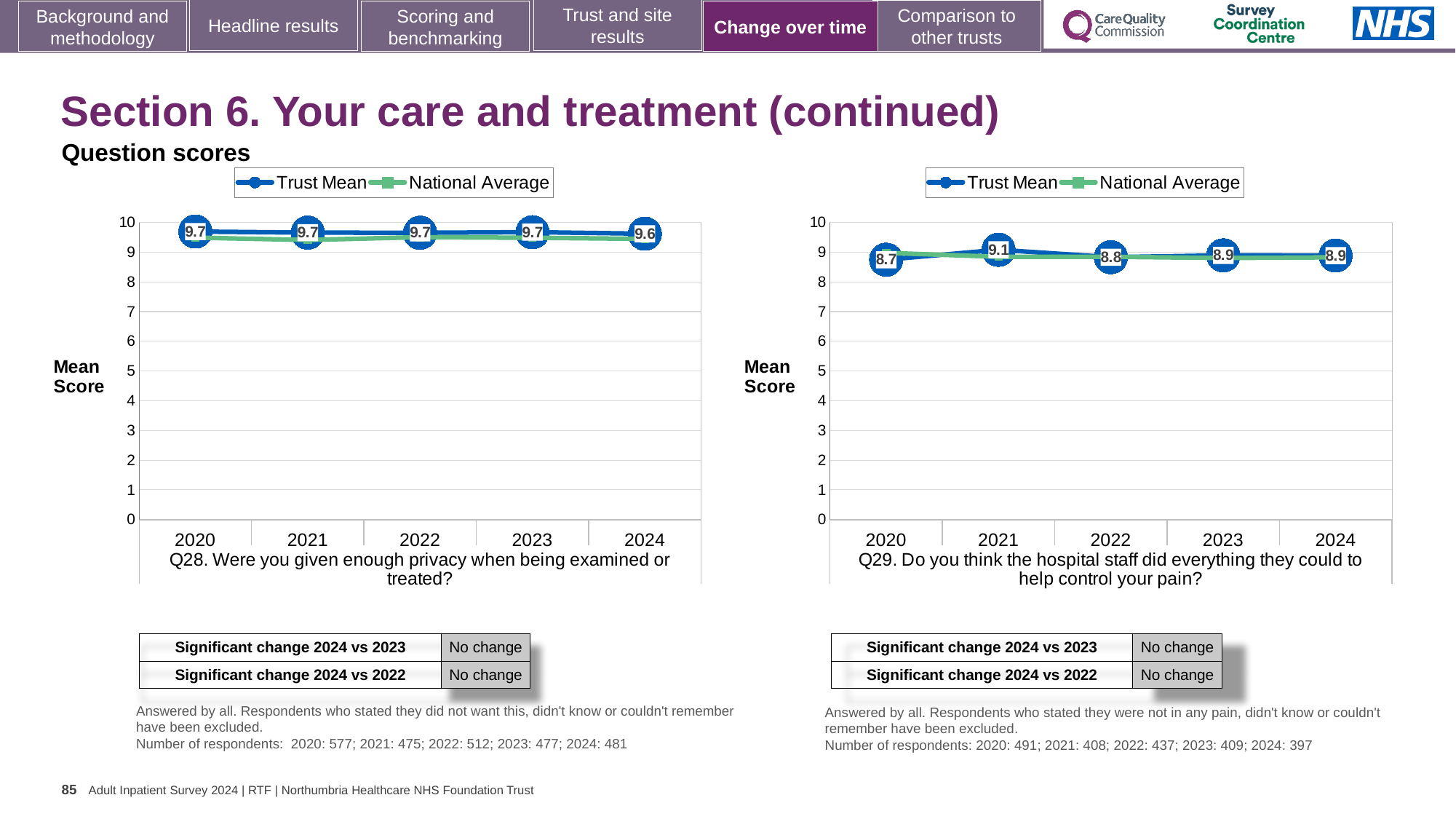
How many series does the legend of the Q29 chart on the right list? 2 What are the two series named in the legend of the Q28 chart on the left? Trust Mean and National Average In the Q28 chart on the left, which is larger: the Trust Mean score for 2023 or for 2024? 2023 In the Q28 chart on the left, is the National Average value for 2022 greater or less than 9? greater In the Q29 chart on the right, which year has the lowest Trust Mean score? 2020 How many years are plotted on the x axis of the Q28 chart on the left? 5 In the Q29 chart on the right, what is the difference between the Trust Mean scores for 2021 and 2020? 0.4 What kind of chart is the Q28 chart on the left? Line chart In the Q29 chart on the right, does the Trust Mean score rise or fall from 2020 to 2021? Rise In the Q29 chart on the right, what is the Trust Mean score for 2020? 8.7 In the Q29 chart on the right, which year has the highest Trust Mean score? 2021 In the Q28 chart on the left, what is the Trust Mean score for 2024? 9.6